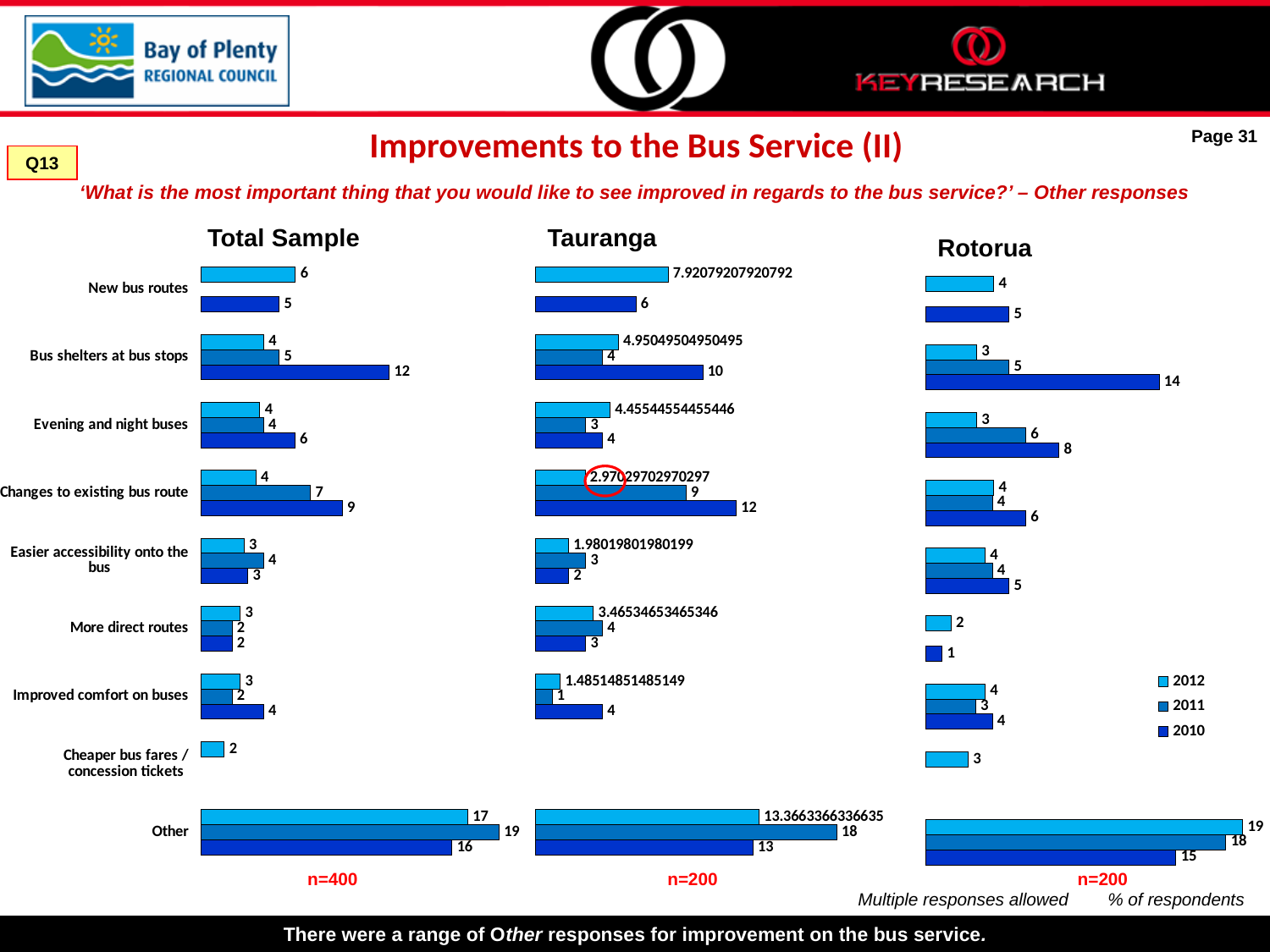
In the Total Sample chart, what is the 2010 value for Bus shelters at bus stops? 12 In the Tauranga chart, what is the 2010 value for Changes to existing bus route? 12 How many categories are shown in the Total Sample chart? 9 In the Tauranga chart, which is larger for Other: the 2011 value or the 2010 value? 2011 How many series does the legend list? 3 In the Rotorua chart, which is larger for Evening and night buses: the 2010 value or the 2011 value? 2010 In the Rotorua chart, which category has the lowest 2010 value? More direct routes What type of chart is the Rotorua chart? Bar chart In the Total Sample chart, which category has the highest 2011 value? Other In the Rotorua chart, what is the 2012 value for Other? 19 In the Total Sample chart, what is the difference between the 2011 and 2012 values for Other? 2 In the Rotorua chart, what is the difference between the 2010 and 2012 values for Bus shelters at bus stops? 11